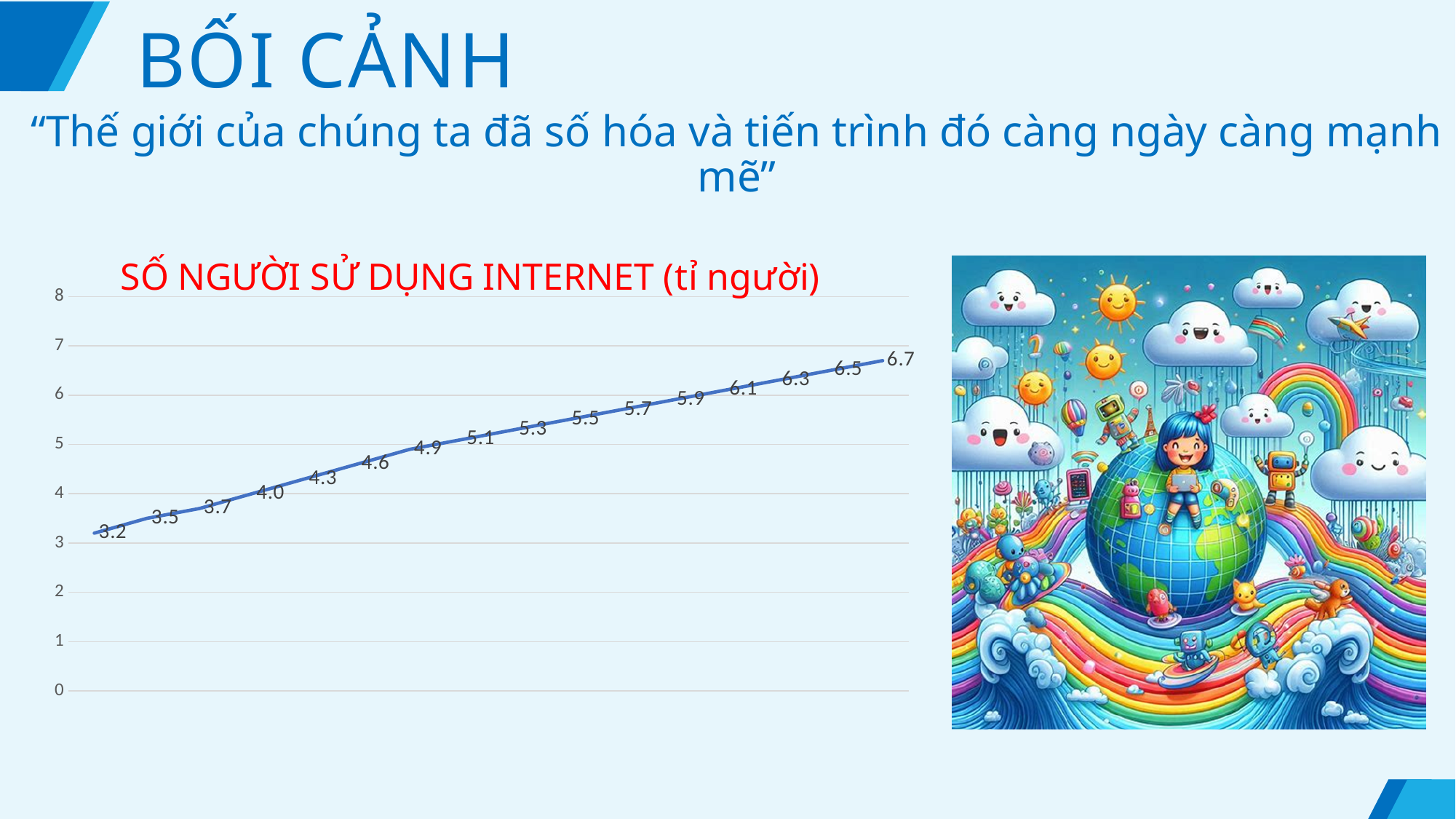
Do the values rise or fall from left to right along the x axis? rise What is the maximum value shown on the vertical axis? 8 What is the highest value plotted on the chart? 6.7 What is the title of the chart? SỐ NGƯỜI SỬ DỤNG INTERNET (tỉ người) What kind of chart is shown on the slide? line chart What is the difference between the last value (6.7) and the first value (3.2)? 3.5 Is the value of the last point on the line greater or less than 6? greater Is the value of the first point on the line greater or less than 4? less How many data points are plotted on the line? 16 What is the value of the last (rightmost) point on the line? 6.7 What is the value of the first (leftmost) point on the line? 3.2 What is the lowest value plotted on the chart? 3.2